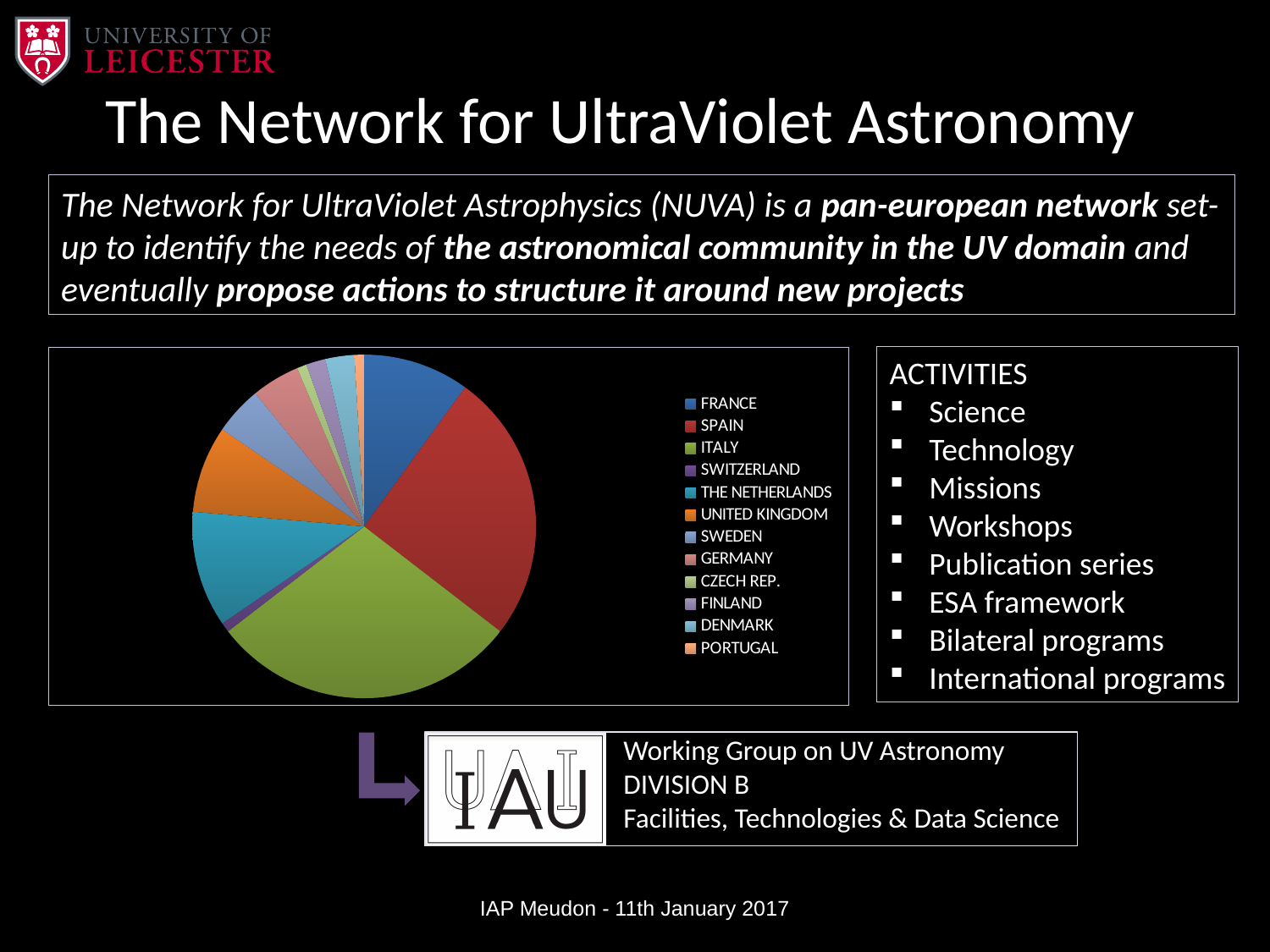
Which is larger in the pie chart, the slice for SPAIN or the slice for PORTUGAL? SPAIN Which is larger in the pie chart, the slice for THE NETHERLANDS or the slice for DENMARK? THE NETHERLANDS Which is larger in the pie chart, the slice for ITALY or the slice for SWEDEN? ITALY What kind of chart is shown on the slide? pie chart How many countries are listed in the pie chart's legend? 12 What colour is the SPAIN slice in the pie chart? red How many data series does the pie chart plot? 1 Which country is listed first in the pie chart's legend? FRANCE